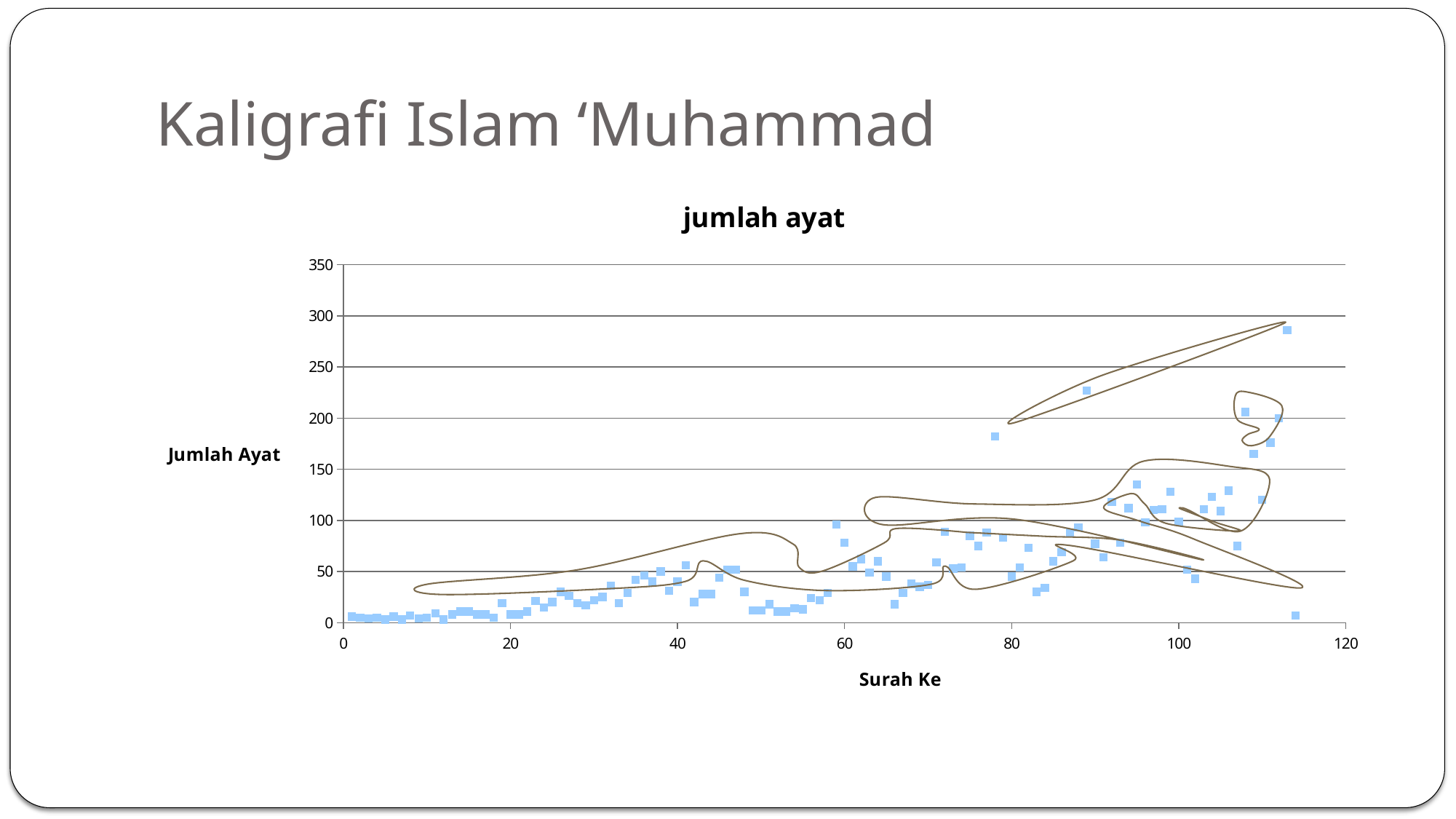
Is the plotted value near Surah Ke 78 greater or less than 150? greater What kind of chart is shown on the slide? scatter chart Is the highest plotted point on the chart greater or less than 300? less Which is larger: the plotted value near Surah Ke 113 or the plotted value near Surah Ke 10? Surah Ke 113 What is the title of the chart? jumlah ayat Is the highest plotted point on the chart greater or less than 250? greater What is the label of the horizontal axis of the chart? Surah Ke Do the plotted values generally rise or fall as Surah Ke increases along the x axis? rise